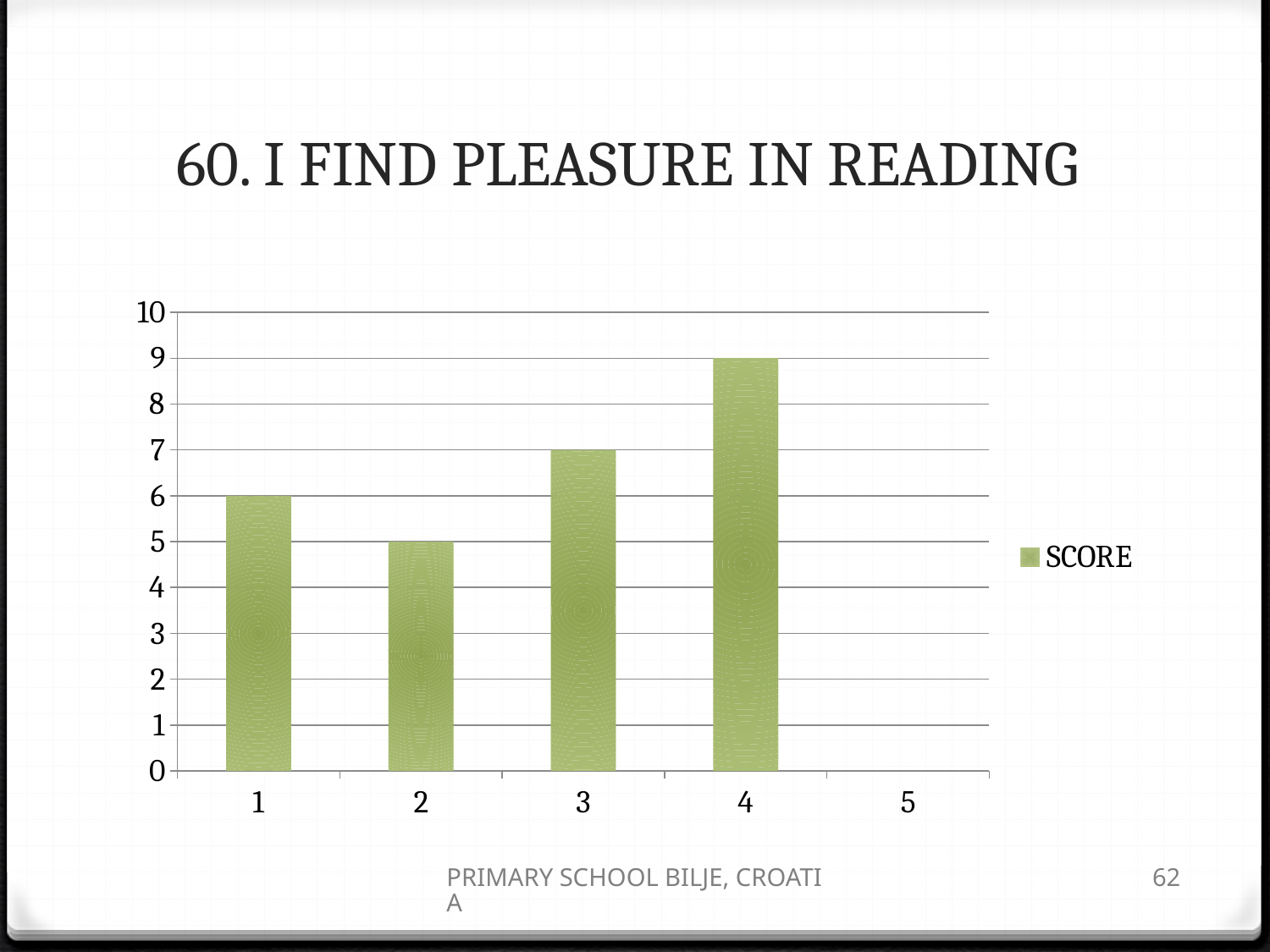
What is the SCORE value for category 2? 5 How many series does the legend list? 1 What is the title of the slide containing the chart? 60. I FIND PLEASURE IN READING What is the difference between the SCORE for category 4 and the SCORE for category 2? 4 What is the SCORE value for category 4? 9 How many categories are shown on the x axis? 5 What type of chart is shown on the slide? bar chart Among categories 1 to 4, which has the lowest SCORE? 2 What is the SCORE value for category 1? 6 Which category has the tallest bar? 4 What is the SCORE value for category 3? 7 Which has a higher SCORE, category 1 or category 3? category 3